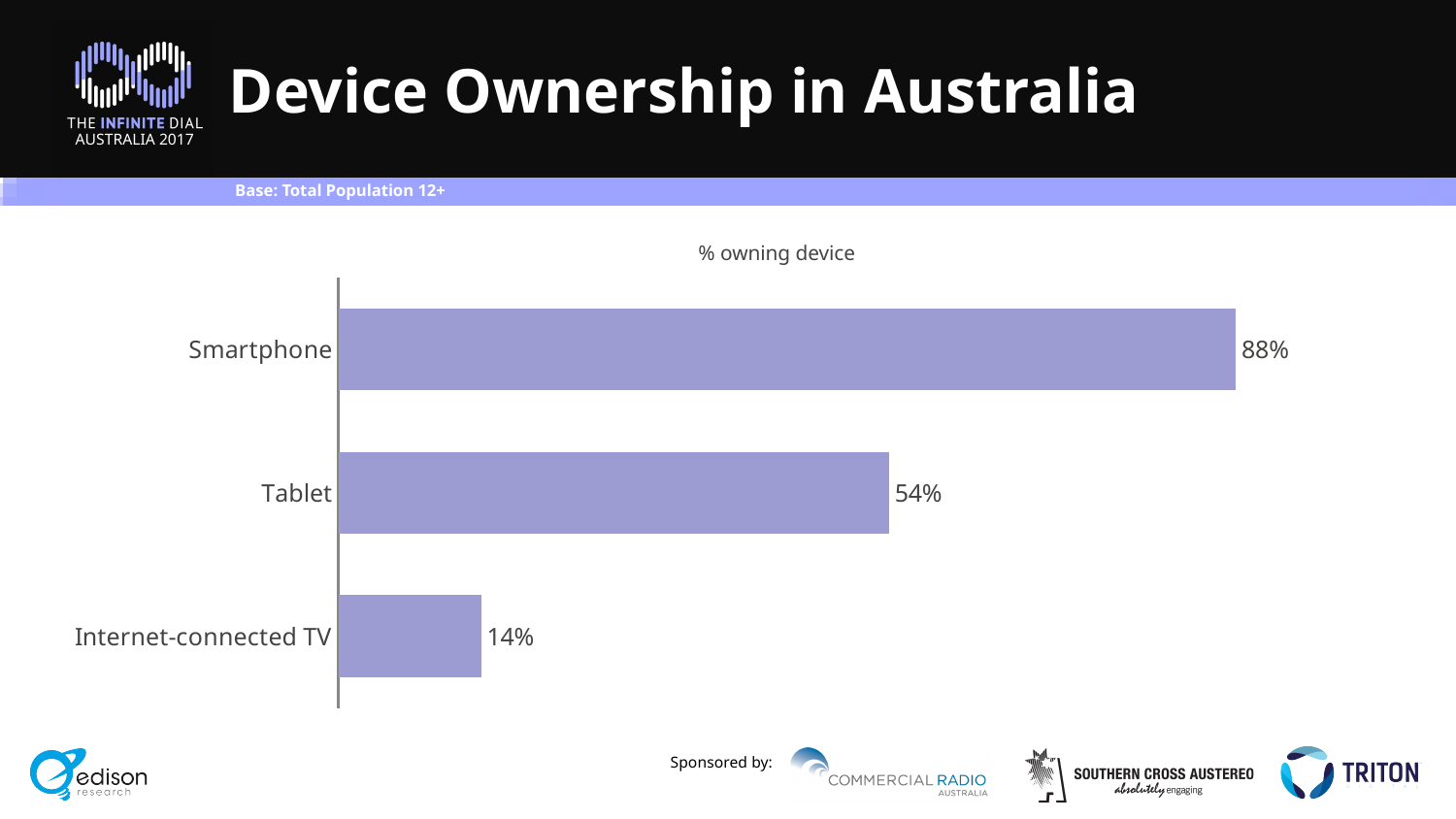
How many device categories are shown in the chart? 3 Which device has the highest ownership percentage? Smartphone What percentage of the population owns a smartphone? 88% Which has a higher ownership percentage, Tablet or Internet-connected TV? Tablet What is the title of the chart? % owning device What type of chart is shown on the slide? Bar chart What percentage of the population owns an Internet-connected TV? 14% What is the difference in ownership percentage between Smartphone and Tablet? 34% What percentage of the population owns a tablet? 54% What is the difference in ownership percentage between Tablet and Internet-connected TV? 40% Which device has the lowest ownership percentage? Internet-connected TV What is the base population stated for the chart? Total Population 12+